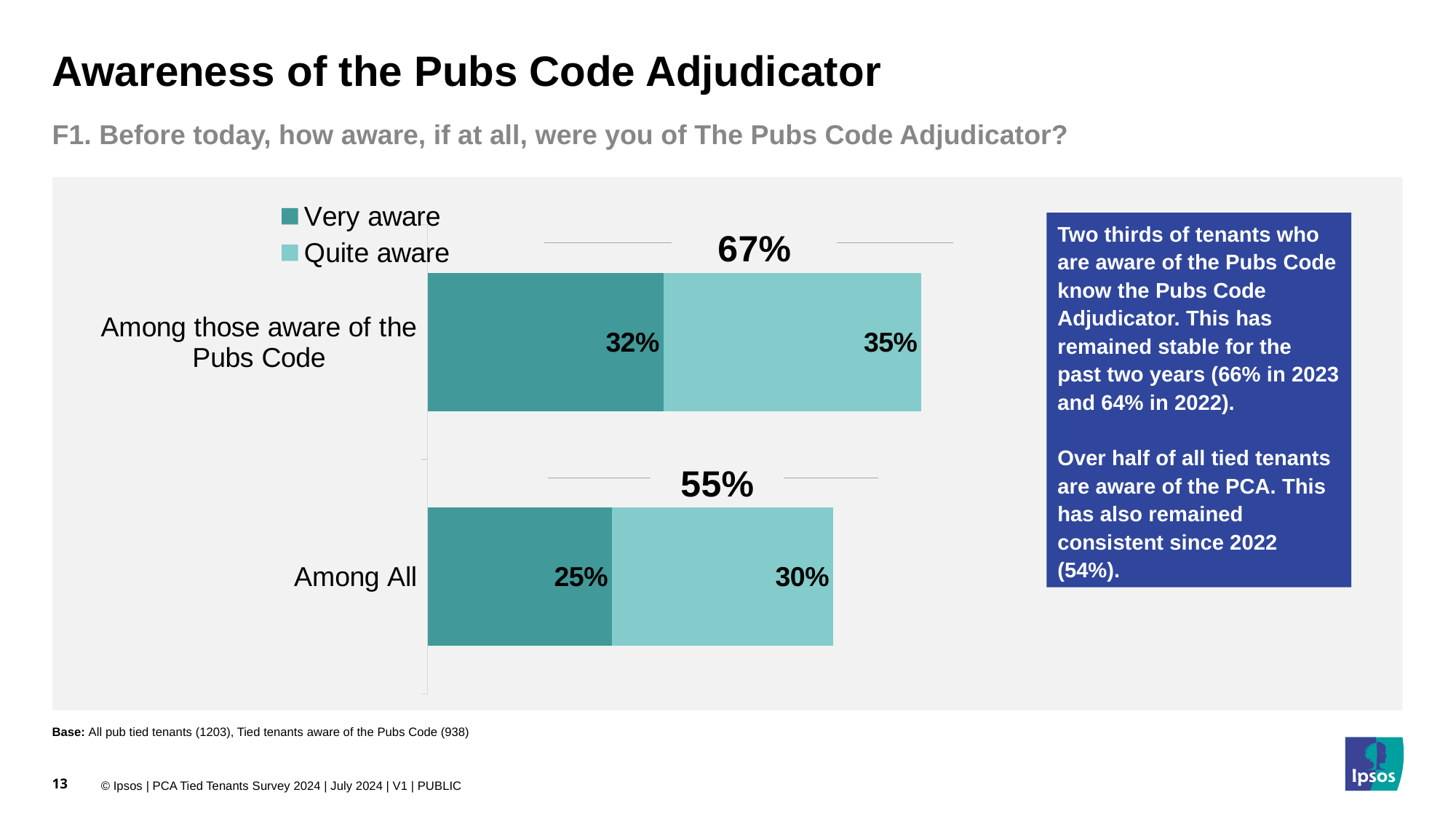
What is the difference between the 'Very aware' values for 'Among those aware of the Pubs Code' and 'Among All'? 7 percentage points What is the total awareness shown above the 'Among those aware of the Pubs Code' bar? 67% How many series does the legend list? 2 Which group has the higher 'Quite aware' value, 'Among those aware of the Pubs Code' or 'Among All'? Among those aware of the Pubs Code What is the total awareness shown above the 'Among All' bar? 55% What percentage of those aware of the Pubs Code are 'Quite aware' of the Pubs Code Adjudicator? 35% What kind of chart is shown on the slide? Stacked bar chart How many categories (bars) are shown in the chart? 2 What percentage of those aware of the Pubs Code are 'Very aware' of the Pubs Code Adjudicator? 32% What is the 'Quite aware' value for the 'Among All' bar? 30% What is the 'Very aware' value for the 'Among All' bar? 25% What is the difference between the total awareness for 'Among those aware of the Pubs Code' and 'Among All'? 12 percentage points